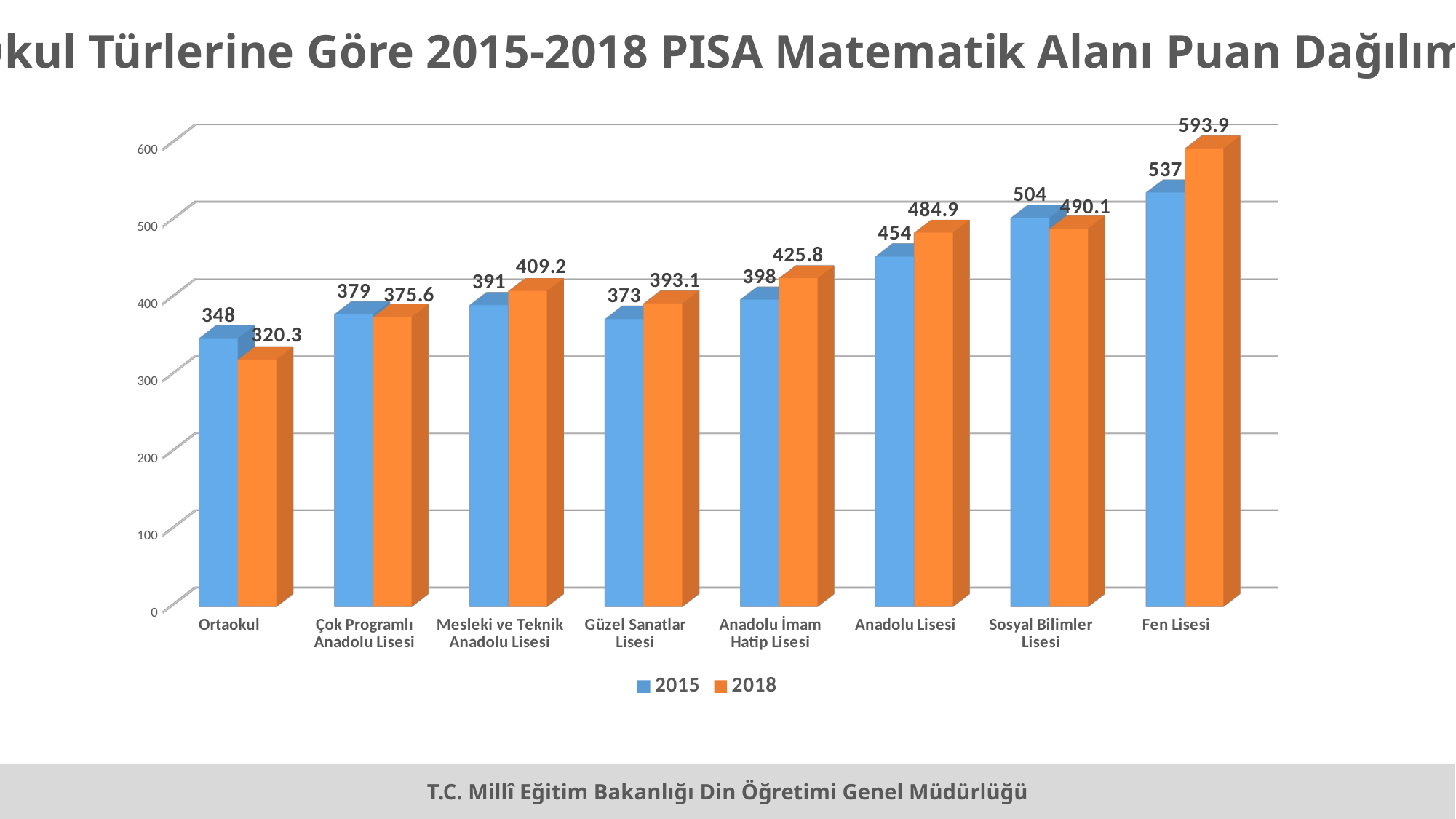
What is the difference between the 2018 and 2015 values for Fen Lisesi? 56.9 What kind of chart is shown on the slide? bar chart What is the 2018 value for Ortaokul? 320.3 Is the 2018 value for Anadolu Lisesi greater or less than 500? less What is the difference between the 2015 and 2018 values for Sosyal Bilimler Lisesi? 13.9 Which school type has the lowest 2015 value? Ortaokul How many school types are shown on the x axis? 8 How many series does the legend list? 2 What is the 2015 value for Sosyal Bilimler Lisesi? 504 For Güzel Sanatlar Lisesi, which is larger: the 2015 value or the 2018 value? 2018 Which school type has the highest 2018 value? Fen Lisesi What is the 2018 value for Anadolu İmam Hatip Lisesi? 425.8